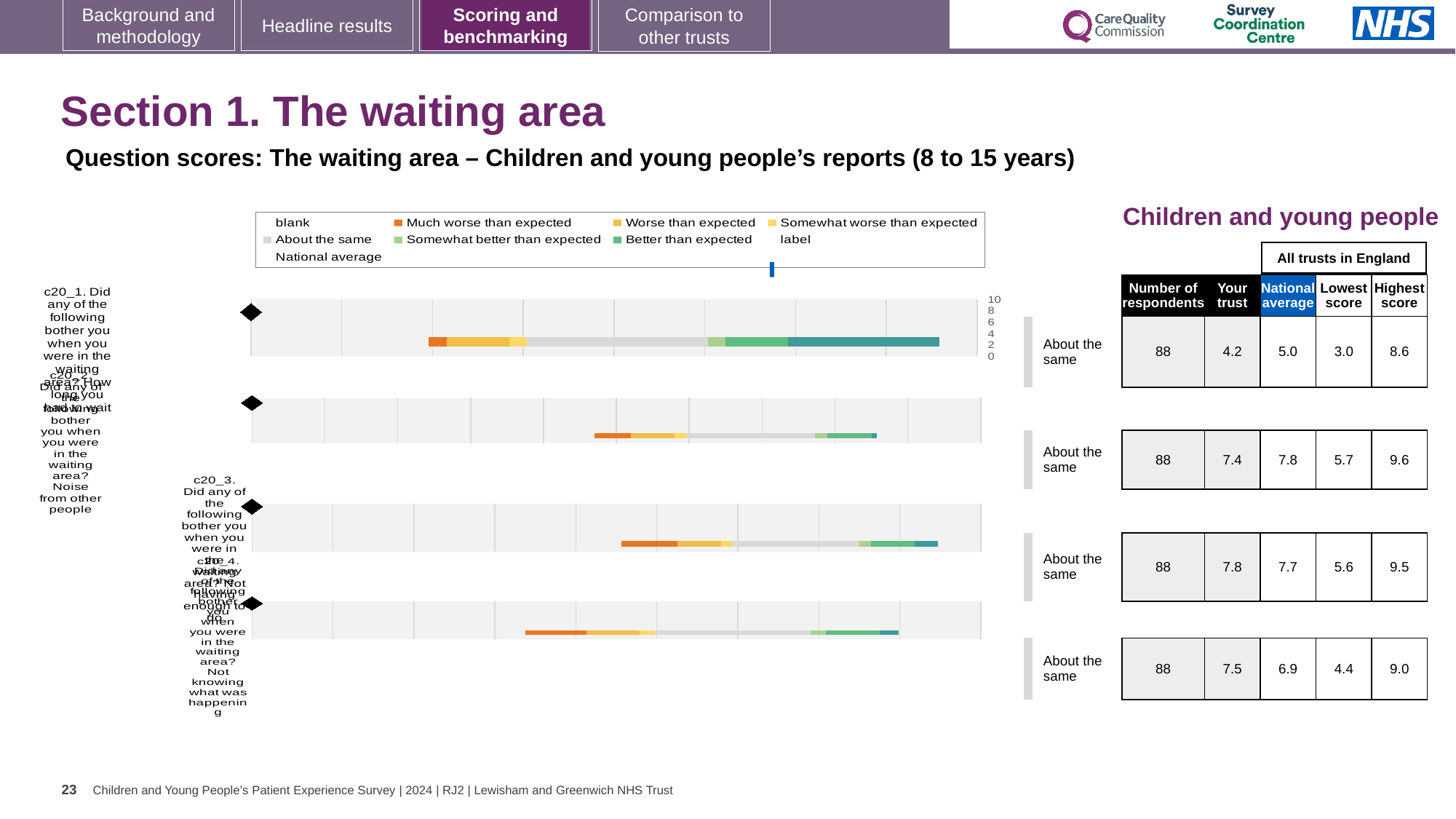
How many entries does the chart legend list? 9 For the first question row (c20_1), what is the 'Your trust' score? 4.2 For the second question row (c20_2), what is the difference between the Highest score and the Lowest score? 3.9 For the first question row (c20_1), which is larger: the 'Your trust' score or the National average? National average Which question row has the highest 'Your trust' score? the third row (c20_3), 7.8 What kind of chart is used to show the question scores on this slide? bar chart For the second question row (c20_2), what is the National average score? 7.8 How many respondents are reported for each question row? 88 For the third question row (c20_3), what is the Highest score among all trusts in England? 9.5 How many question rows (bar charts) are shown on the slide? 4 For the fourth question row (c20_4), what is the Lowest score among all trusts in England? 4.4 Which legend entry is shown in orange? Much worse than expected